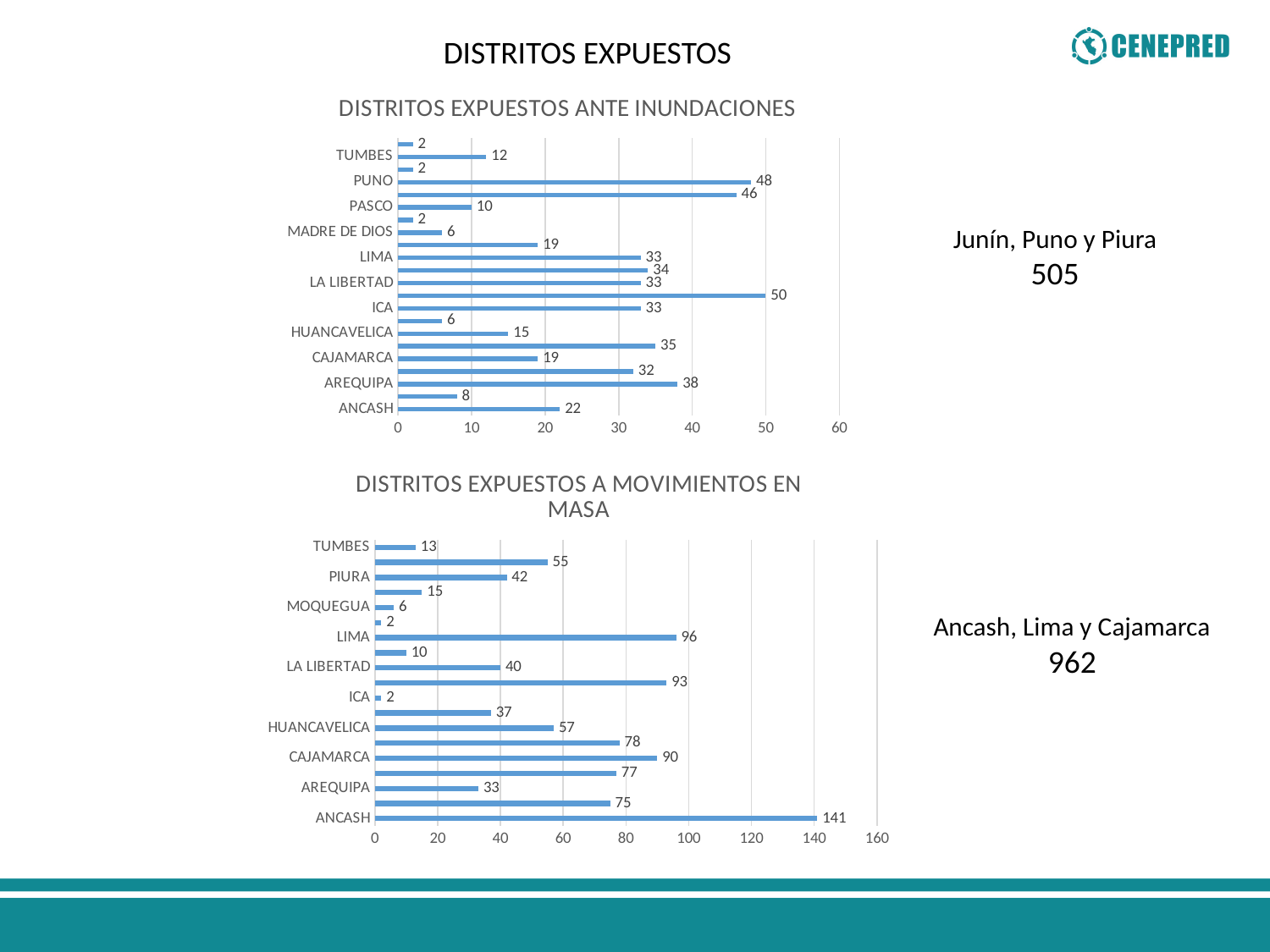
In the chart titled DISTRITOS EXPUESTOS A MOVIMIENTOS EN MASA, which has the larger value, LIMA or CAJAMARCA? LIMA In the chart titled DISTRITOS EXPUESTOS A MOVIMIENTOS EN MASA, what is the value for MOQUEGUA? 6 In the chart titled DISTRITOS EXPUESTOS ANTE INUNDACIONES, what is the difference between the values for PUNO and ANCASH? 26 In the chart titled DISTRITOS EXPUESTOS ANTE INUNDACIONES, what is the value for AREQUIPA? 38 In the chart titled DISTRITOS EXPUESTOS ANTE INUNDACIONES, what is the highest value shown on any bar? 50 In the chart titled DISTRITOS EXPUESTOS A MOVIMIENTOS EN MASA, what is the value for ANCASH? 141 In the chart titled DISTRITOS EXPUESTOS ANTE INUNDACIONES, which has the larger value, LIMA or HUANCAVELICA? LIMA In the chart titled DISTRITOS EXPUESTOS A MOVIMIENTOS EN MASA, which labeled category has the highest value? ANCASH In the chart titled DISTRITOS EXPUESTOS A MOVIMIENTOS EN MASA, what is the difference between the values for CAJAMARCA and HUANCAVELICA? 33 In the chart titled DISTRITOS EXPUESTOS ANTE INUNDACIONES, what is the value for PUNO? 48 How many charts are shown on the slide? 2 What kind of chart is the top chart, DISTRITOS EXPUESTOS ANTE INUNDACIONES? Bar chart